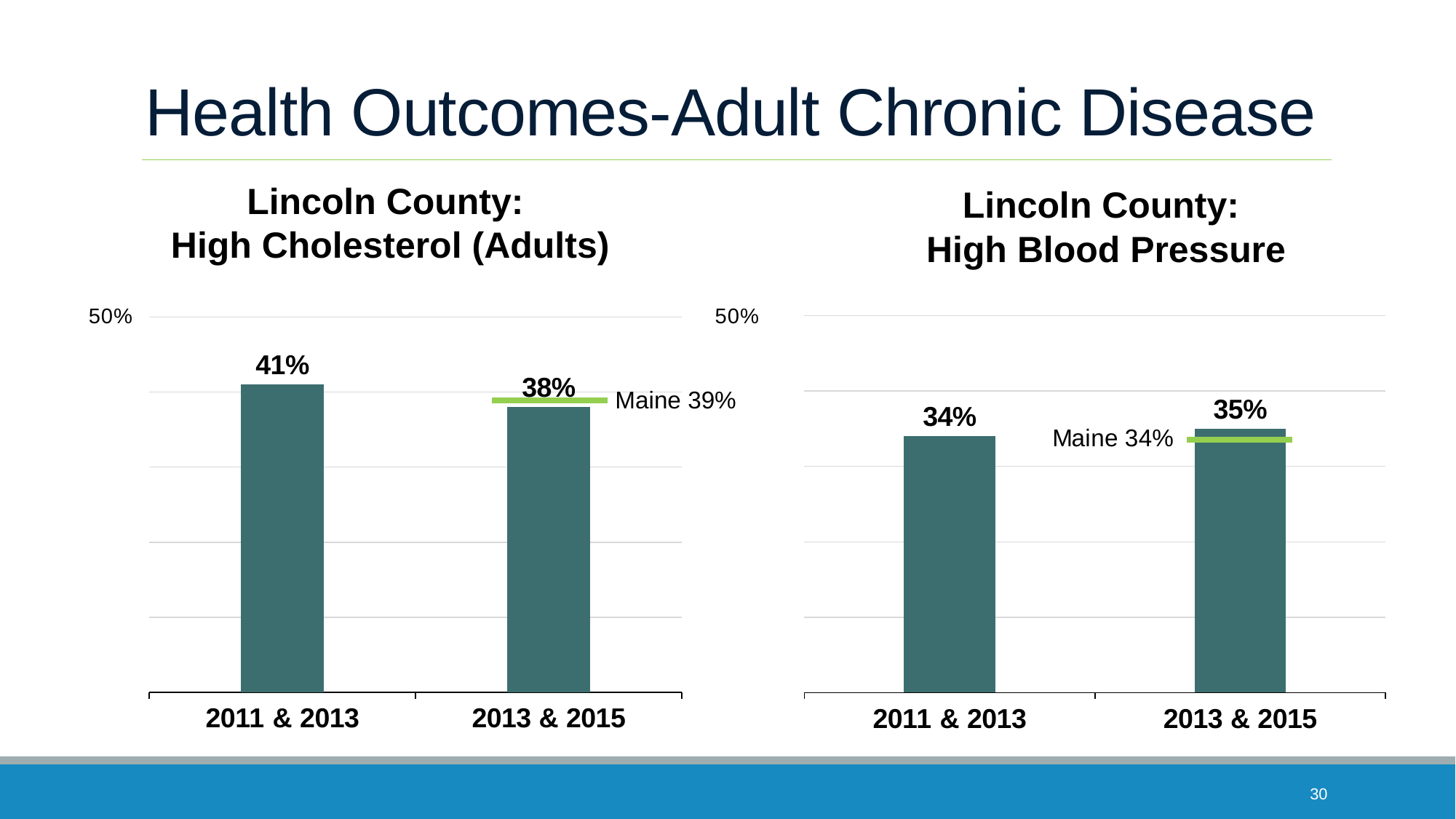
In the High Blood Pressure chart, what is the value for 2013 & 2015? 35% What kind of chart is the High Blood Pressure chart? bar chart In the High Blood Pressure chart, what is the value for 2011 & 2013? 34% In the High Cholesterol (Adults) chart, what is the value for 2011 & 2013? 41% In the High Blood Pressure chart, which period has the lower value? 2011 & 2013 How many bars are in the High Cholesterol (Adults) chart? 2 In the High Cholesterol (Adults) chart, what is the Maine value shown next to the 2013 & 2015 bar? 39% In the High Blood Pressure chart, what is the Maine value shown next to the 2013 & 2015 bar? 34% In the High Cholesterol (Adults) chart, what is the difference between the 2011 & 2013 value and the 2013 & 2015 value? 3% In the High Cholesterol (Adults) chart, which period has the higher value? 2011 & 2013 In the High Blood Pressure chart, do the values rise or fall from 2011 & 2013 to 2013 & 2015? rise In the High Cholesterol (Adults) chart, what is the value for 2013 & 2015? 38%